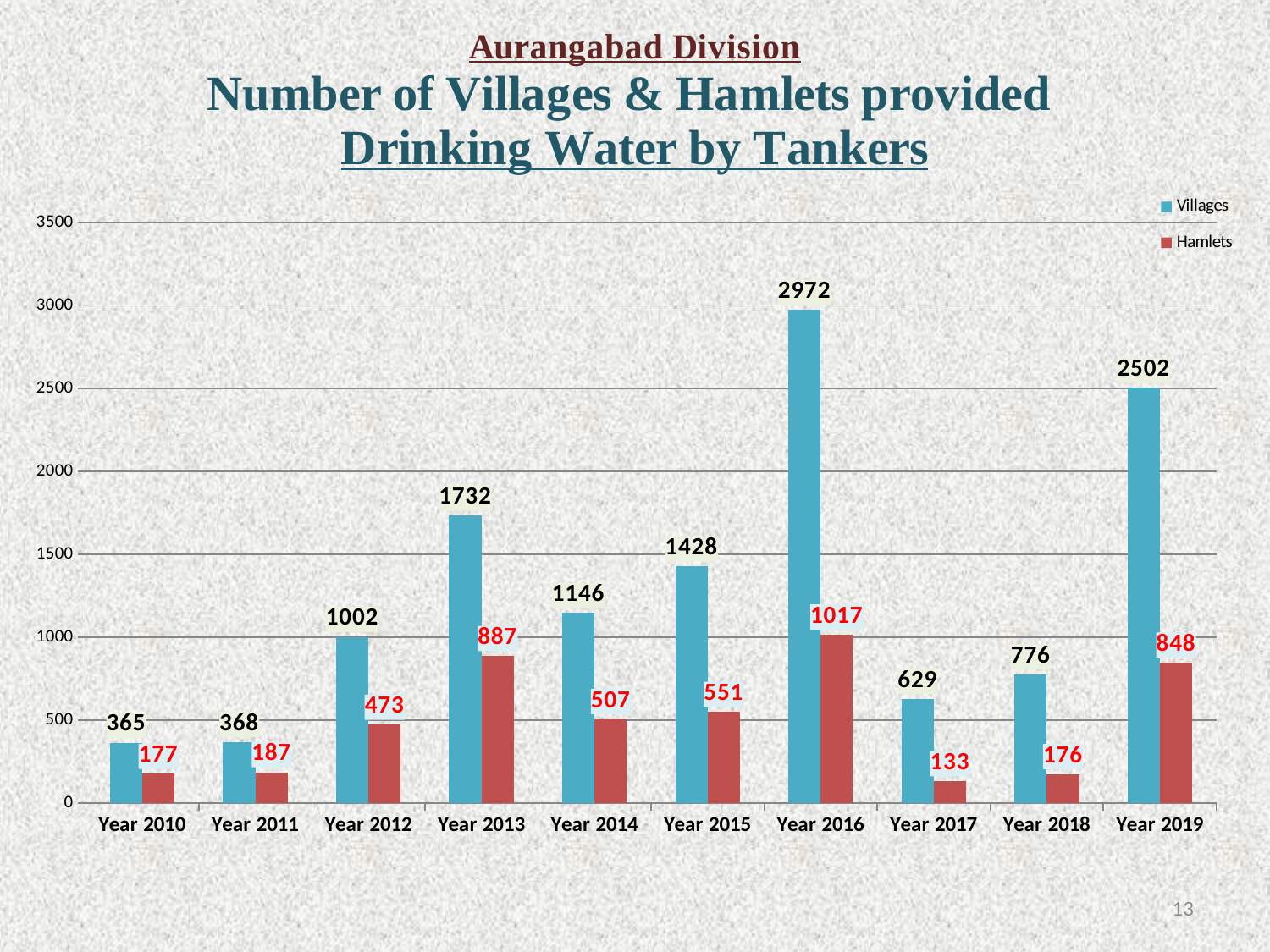
Is the value for Villages in Year 2018 greater or less than 1000? less Which year has the lowest value for Hamlets? Year 2017 How many villages were provided drinking water by tankers in Year 2016? 2972 Do the Villages values rise or fall from Year 2016 to Year 2017? fall How many years are shown on the x axis? 10 Which year has the highest value for Villages? Year 2016 What colour are the Hamlets bars? red What kind of chart is shown on the slide? bar chart Which is larger, the Hamlets value in Year 2012 or the Hamlets value in Year 2015? Year 2015 How many series does the legend list? 2 What is the value for Hamlets in Year 2013? 887 What is the difference between the Villages and Hamlets values in Year 2019? 1654